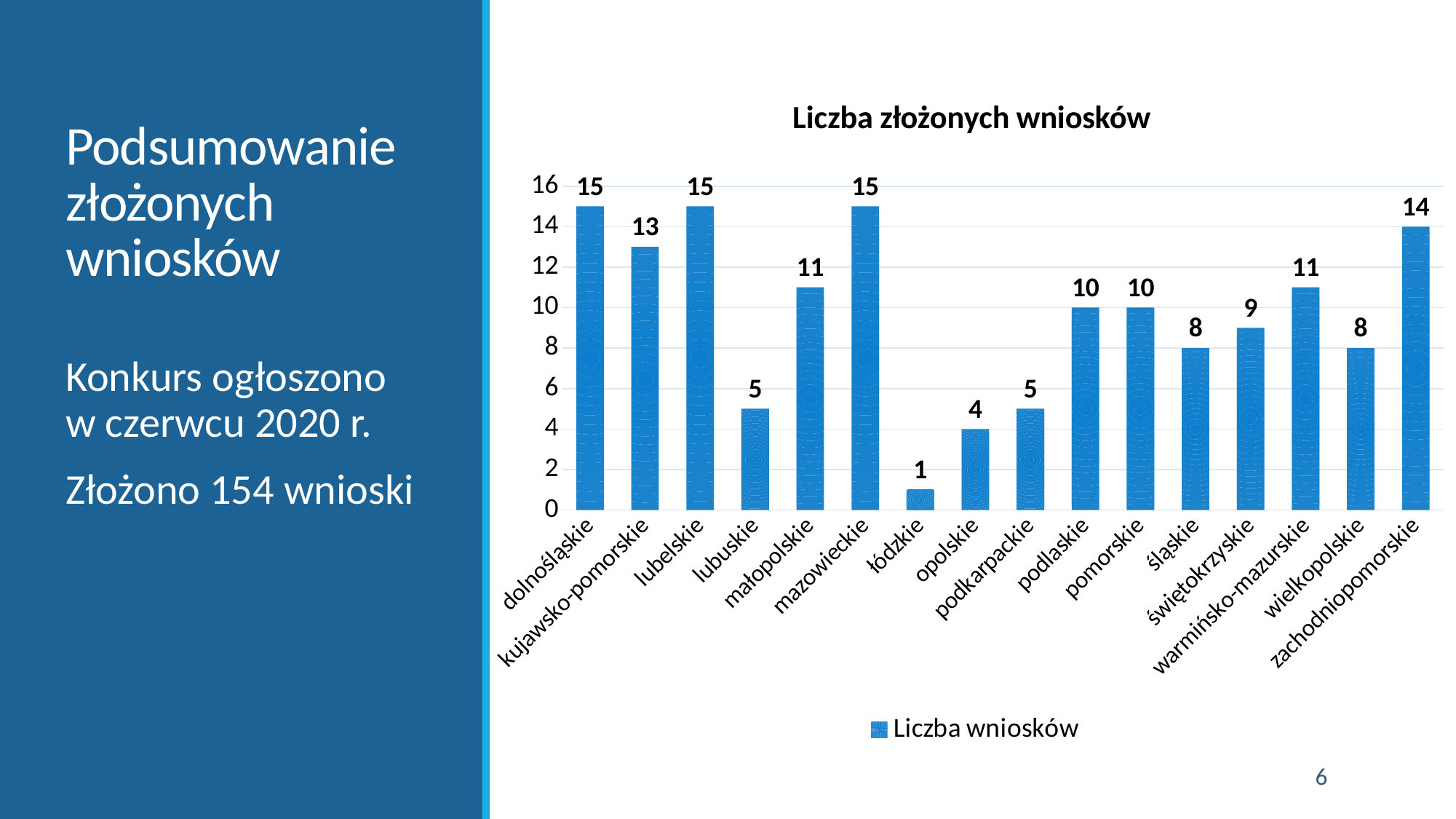
How many series does the legend list? 1 What is the title of the chart? Liczba złożonych wniosków What is the difference between the values for mazowieckie and łódzkie? 14 What is the value for świętokrzyskie? 9 What is the value for opolskie? 4 How many categories are shown on the x axis of the chart? 16 What is the difference between the values for zachodniopomorskie and wielkopolskie? 6 What is the value for kujawsko-pomorskie in the chart? 13 How many applications are shown for zachodniopomorskie? 14 Which is larger, the value for małopolskie or the value for podlaskie? małopolskie What kind of chart is shown on the slide? bar chart Which category has the lowest value in the chart? łódzkie